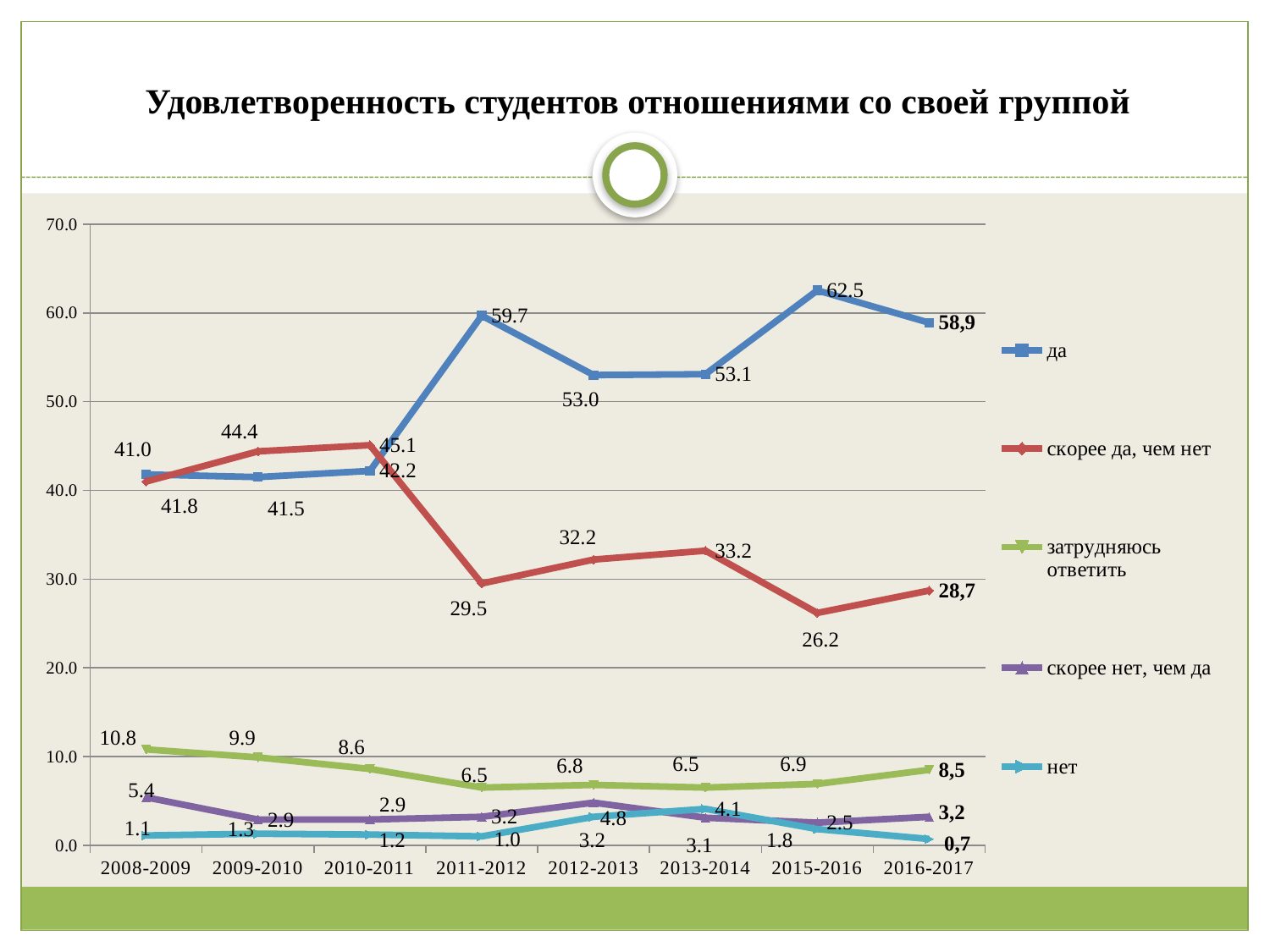
What is the value for "нет" in 2016-2017? 0,7 In which year is the "скорее да, чем нет" series lowest? 2015-2016 What is the difference between "да" and "скорее да, чем нет" in 2016-2017? 30,2 What is the value for "скорее да, чем нет" in 2011-2012? 29.5 Does the "затрудняюсь ответить" series rise or fall from 2008-2009 to 2011-2012? fall In 2010-2011, which is larger: "да" or "скорее да, чем нет"? скорее да, чем нет How many series does the legend list? 5 How many academic years are shown on the x axis? 8 What is the value for "да" in 2015-2016? 62.5 What kind of chart is shown on the slide? line chart In which year is the "да" series highest? 2015-2016 What is the value for "затрудняюсь ответить" in 2008-2009? 10.8